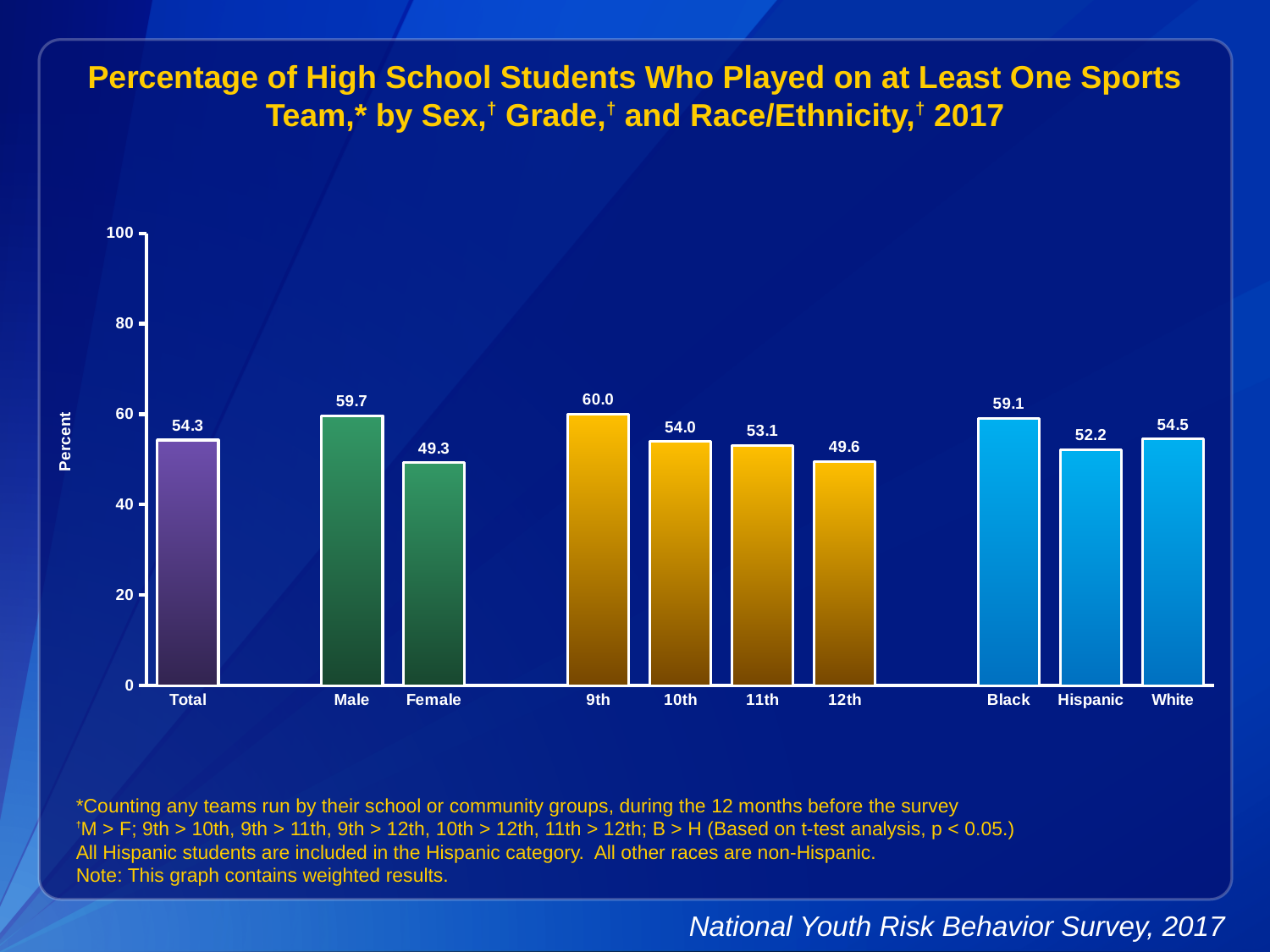
What is the value for Female? 49.3 What kind of chart is this? bar chart What is the value for 12th grade? 49.6 Do the values rise or fall from 9th grade to 12th grade? fall What is the difference between the values for Male and Female? 10.4 Which category has the lowest value? Female Which category has the highest value? 9th How many categories are shown on the x axis? 10 What is the value for Total? 54.3 What is the value for Hispanic? 52.2 Is the value for 10th grade greater or less than 40? greater Which is larger, the value for Black or the value for White? Black